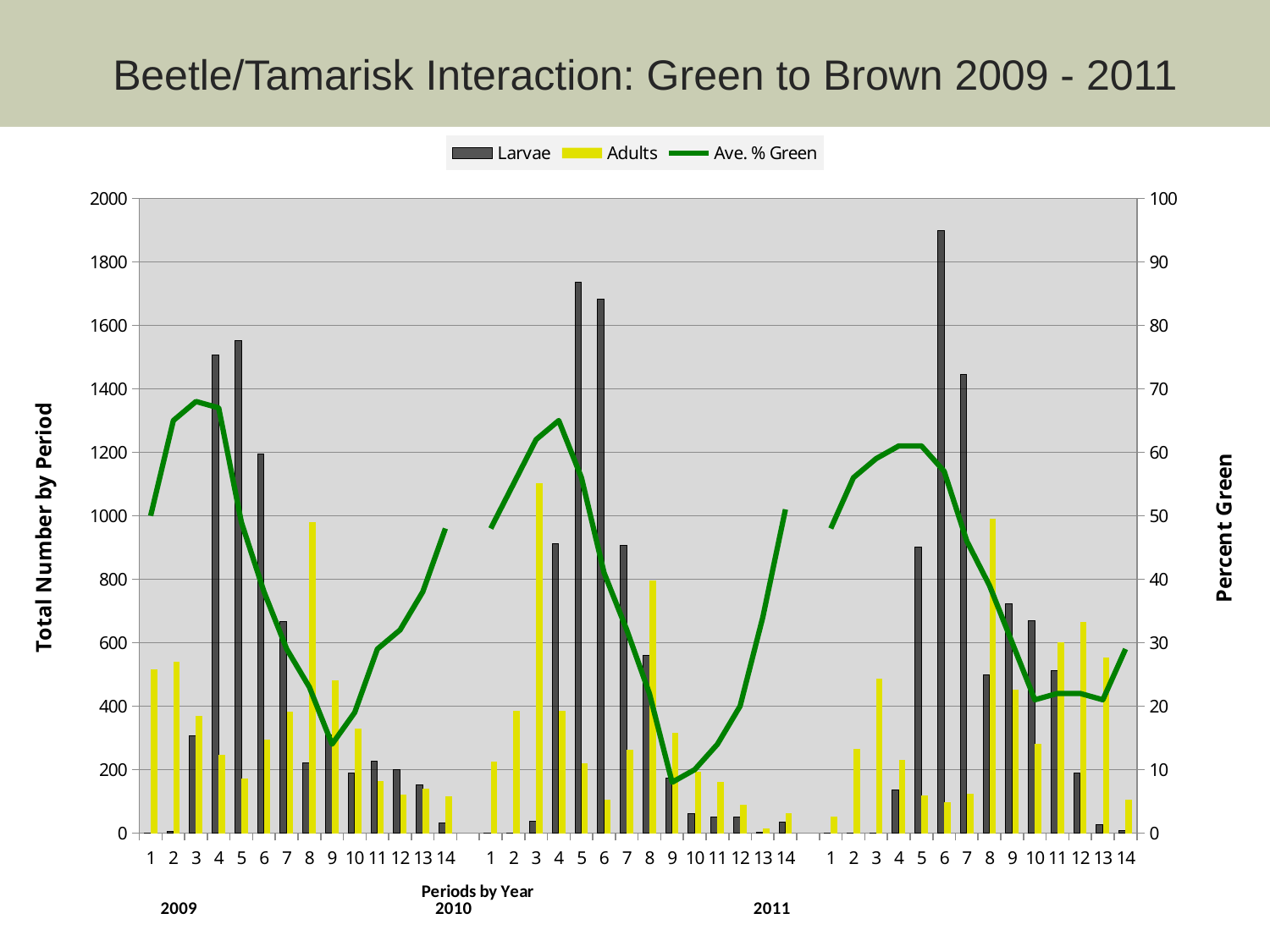
Does the Ave. % Green line rise or fall from period 4 to period 9 of 2010? Fall In which year and period is the Adults bar the highest? 2010, period 3 How many series does the legend list? 3 What kind of chart is shown on the slide? A combined bar and line chart Is the Larvae value for period 6 of 2011 greater or less than 1800? greater Is the Ave. % Green value for period 9 of 2010 greater or less than 10? less What are the three series named in the legend? Larvae, Adults, Ave. % Green How many periods are plotted for each year on the x axis? 14 Which is larger, the Larvae value for period 6 of 2011 or the Larvae value for period 5 of 2010? Period 6 of 2011 In which year and period is the Larvae bar the highest? 2011, period 6 Is the Larvae value for period 5 of 2010 greater or less than 1600? greater What is the label of the right-hand vertical axis? Percent Green